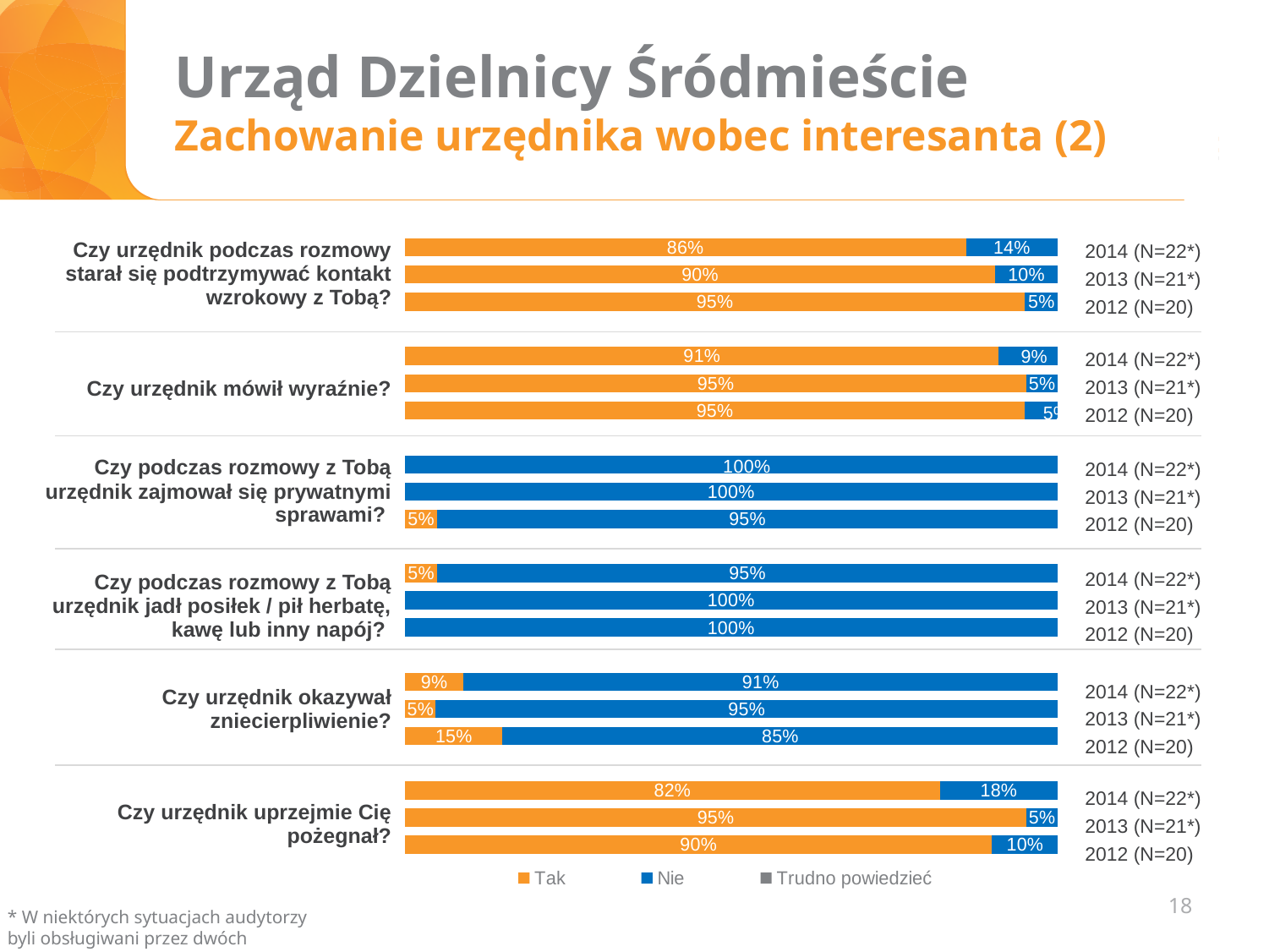
What percentage answered "Nie" in 2014 for "Czy urzędnik uprzejmie Cię pożegnał?"? 18% What percentage answered "Nie" in 2012 for "Czy podczas rozmowy z Tobą urzędnik zajmował się prywatnymi sprawami?"? 95% What percentage answered "Tak" in 2012 for "Czy urzędnik okazywał zniecierpliwienie?"? 15% For "Czy urzędnik podczas rozmowy starał się podtrzymywać kontakt wzrokowy z Tobą?", did the "Tak" share rise or fall from 2012 to 2014? Fall For "Czy urzędnik uprzejmie Cię pożegnał?", what is the difference in percentage points between the "Tak" share in 2013 and in 2014? 13 percentage points In 2014, which had a higher "Tak" share: "Czy urzędnik mówił wyraźnie?" or "Czy urzędnik podczas rozmowy starał się podtrzymywać kontakt wzrokowy z Tobą?"? Czy urzędnik mówił wyraźnie? How many questions (categories) are shown in the chart? 6 What kind of chart is shown on the slide? Stacked bar chart How many series does the legend list? 3 What are the legend entries of the chart? Tak, Nie, Trudno powiedzieć For "Czy urzędnik uprzejmie Cię pożegnał?", which year had the highest "Tak" share? 2013 What percentage answered "Tak" in 2014 for "Czy urzędnik podczas rozmowy starał się podtrzymywać kontakt wzrokowy z Tobą?"? 86%